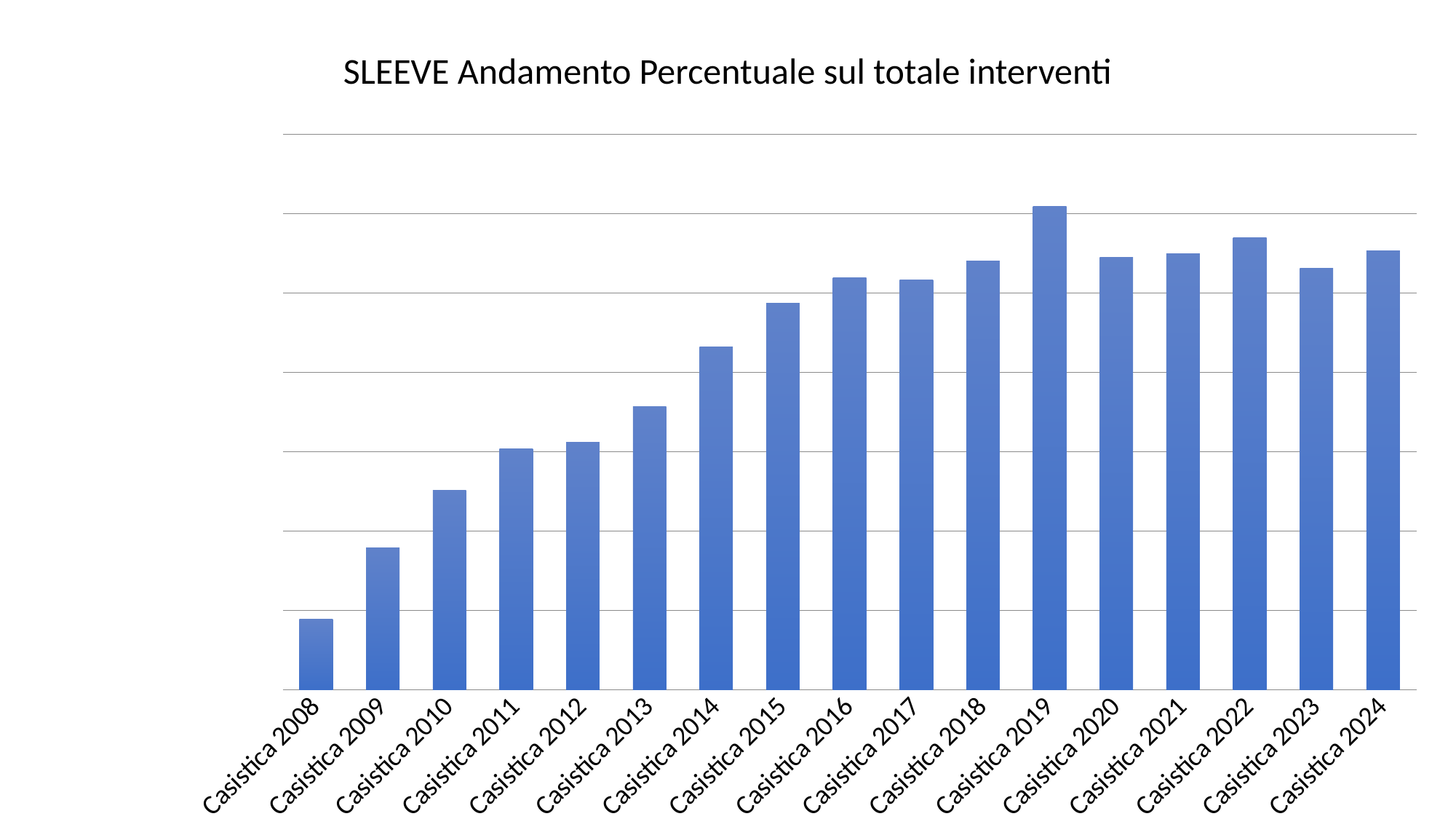
Which is larger, the value for Casistica 2013 or Casistica 2014? Casistica 2014 What kind of chart is shown on the slide? Bar chart What colour are the bars in the chart? Blue Which category has the lowest bar? Casistica 2008 Which is larger, the value for Casistica 2022 or Casistica 2023? Casistica 2022 What is the title of the chart? SLEEVE Andamento Percentuale sul totale interventi Which is larger, the value for Casistica 2014 or Casistica 2015? Casistica 2015 How many categories are shown on the x axis? 17 Do the values generally rise or fall from Casistica 2008 to Casistica 2019? Rise Which category has the highest bar? Casistica 2019